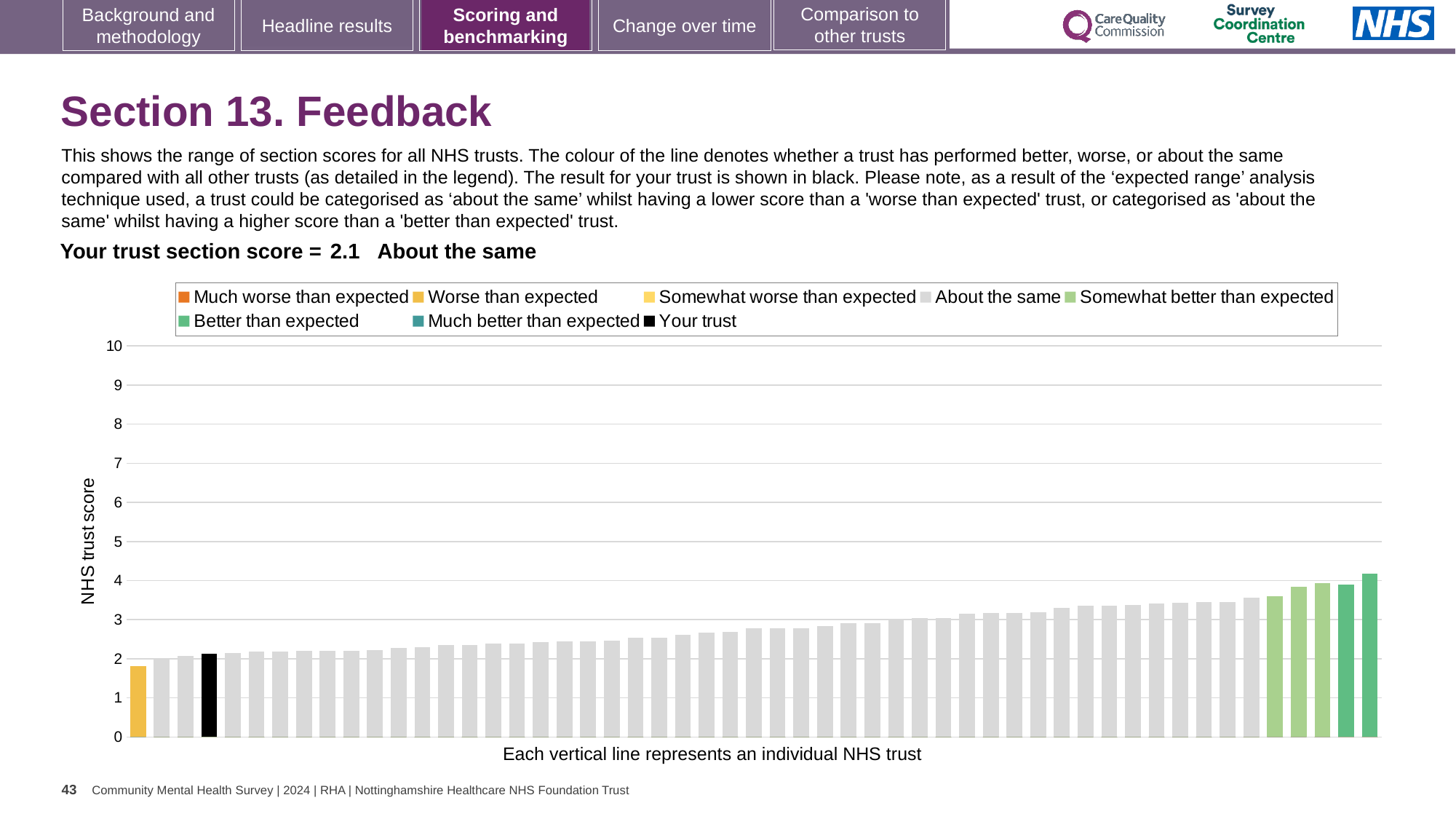
Is the value of the black 'Your trust' bar greater or less than 3? less What is the label on the vertical axis of the chart? NHS trust score What is the section score for your trust shown on the slide? 2.1 What kind of chart is shown on the slide? Bar chart Which is higher: the rightmost bar or the black 'Your trust' bar? The rightmost bar How is your trust's section score categorised compared with other trusts? About the same How many entries does the chart legend list? 8 Is the value of the leftmost (yellow) bar greater or less than 2? less Is the value of the tallest bar greater or less than 5? less Do the bar values rise or fall from left to right along the x axis? Rise Which is higher: the black 'Your trust' bar or the leftmost yellow bar? The black 'Your trust' bar What is the highest value shown on the vertical axis? 10